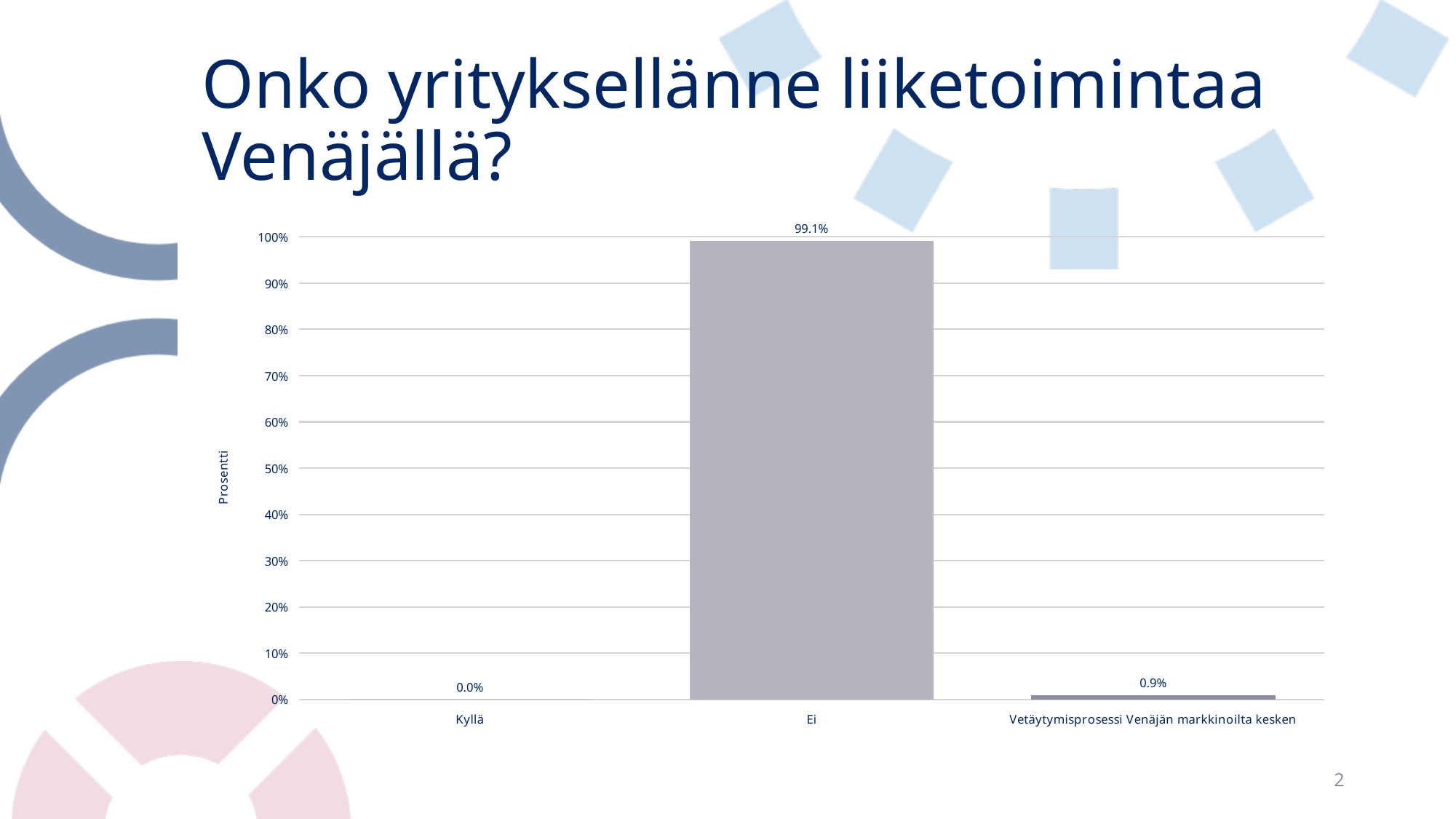
Which category has the highest value? Ei What is the value for "Vetäytymisprosessi Venäjän markkinoilta kesken"? 0.9% How many categories are shown on the x axis? 3 What is the value for "Ei"? 99.1% What is the title of the slide? Onko yrityksellänne liiketoimintaa Venäjällä? What is the label of the vertical axis? Prosentti What is the value for "Kyllä"? 0.0% Which category has the lowest value? Kyllä Which is larger, the value for "Kyllä" or the value for "Vetäytymisprosessi Venäjän markkinoilta kesken"? Vetäytymisprosessi Venäjän markkinoilta kesken Is the value for "Ei" greater or less than 90%? greater What is the difference between the values for "Ei" and "Vetäytymisprosessi Venäjän markkinoilta kesken"? 98.2% What kind of chart is shown on the slide? bar chart